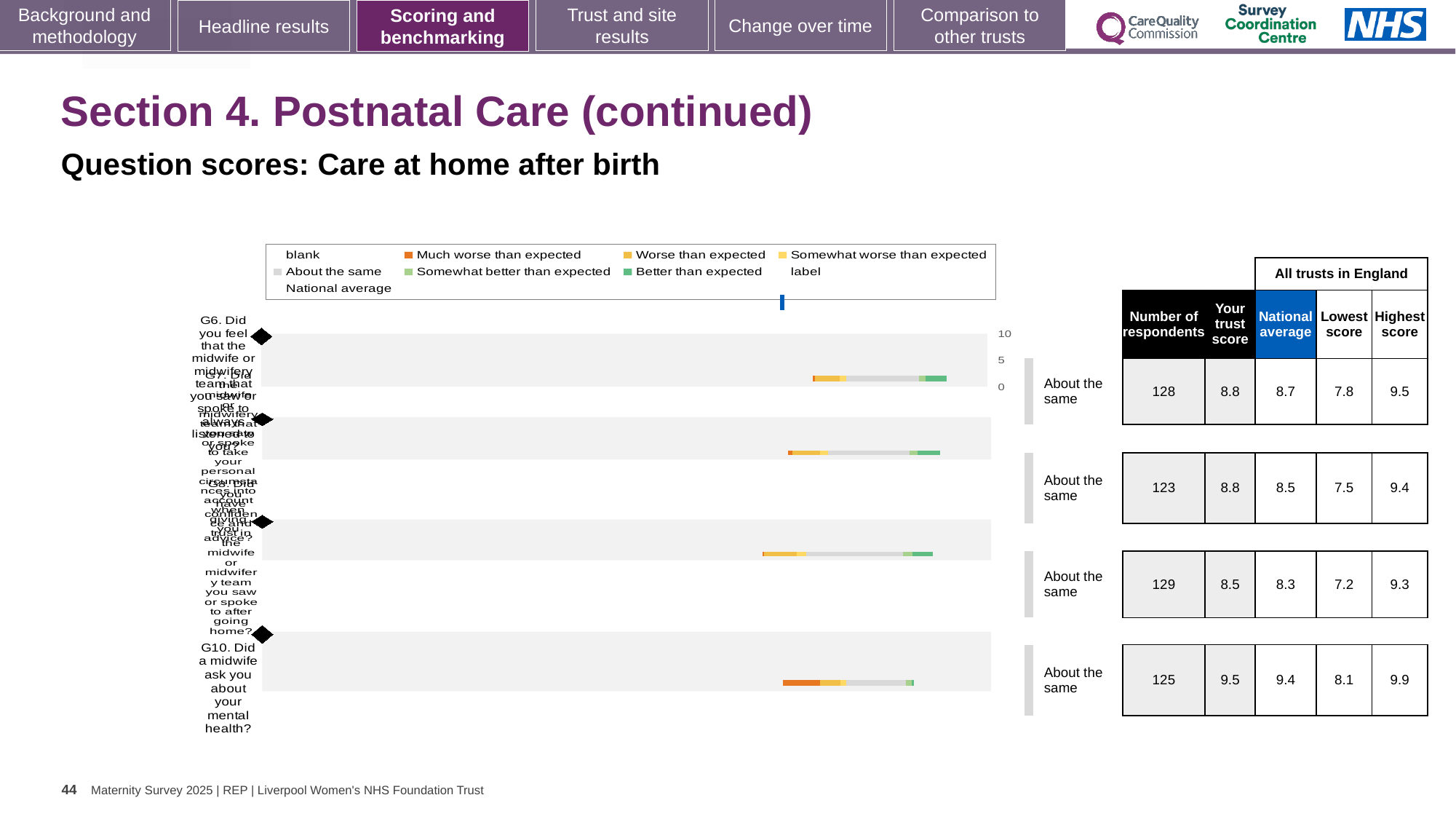
How many survey questions (rows) does the chart show? 4 What is the national average for G10 (Did a midwife ask you about your mental health?)? 9.4 For the first row, G6, which is larger: the trust score or the national average? the trust score (8.8) What is the difference between the trust score and the national average for G10? 0.1 How many respondents answered G10 (Did a midwife ask you about your mental health?)? 125 Which row has the lowest 'Your trust score'? the third row (8.5) What kind of chart is shown on the slide? bar chart What is the 'Your trust score' for G10 (Did a midwife ask you about your mental health?)? 9.5 What is the 'Your trust score' for the first row, G6? 8.8 What is the highest score among all trusts in England for the first row, G6? 9.5 What benchmark category is shown for every row of the chart? About the same Which row has the highest 'Your trust score'? G10